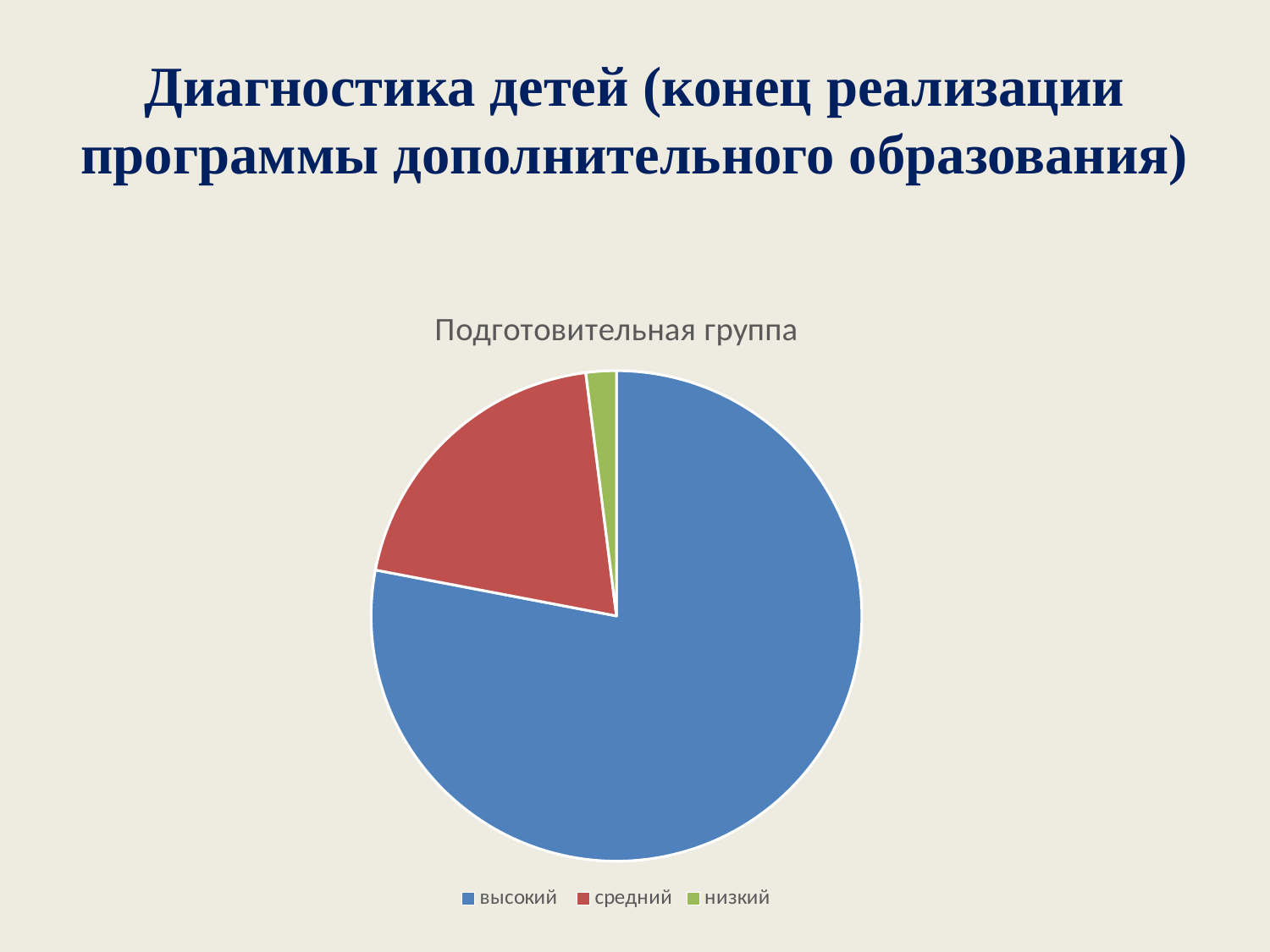
Which category has the smallest slice of the pie chart? низкий Which category has the largest slice of the pie chart? высокий What is the title of the pie chart? Подготовительная группа Does the slice for высокий take up more or less than half of the pie? more How many slices does the pie chart have? 3 How many entries does the legend of the pie chart list? 3 What kind of chart is shown on the slide? pie chart Which slice is larger, высокий or средний? высокий Which slice is larger, средний or низкий? средний Which colour represents the category средний in the pie chart? red